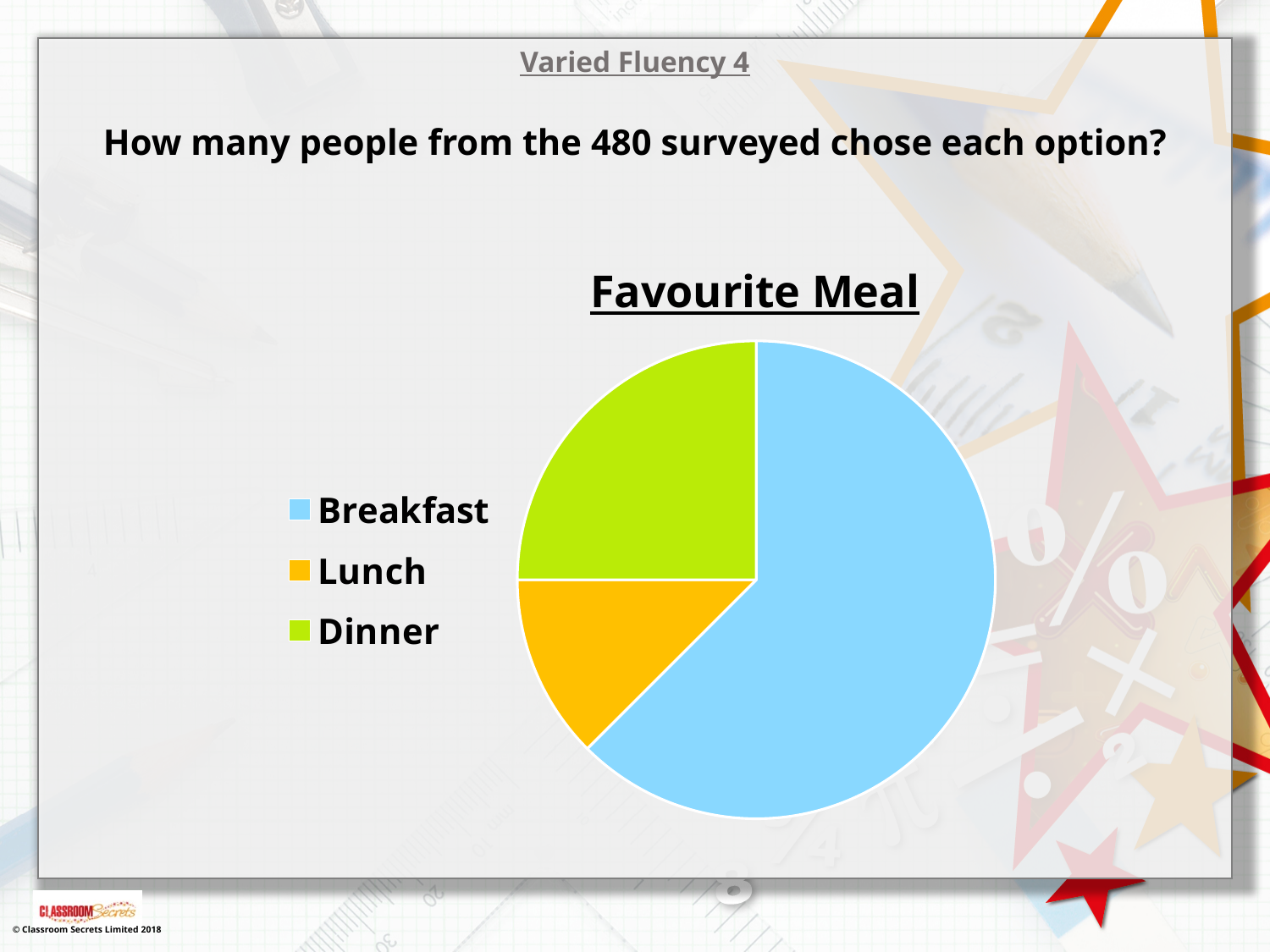
How many entries does the legend list? 3 What type of chart is shown on the slide? pie chart What is the title of the chart? Favourite Meal Which meal has the smallest slice of the pie chart? Lunch Which slice is larger, Lunch or Dinner? Dinner Which meal has the largest slice of the pie chart? Breakfast Which slice is larger, Breakfast or Dinner? Breakfast How many categories does the pie chart show? 3 Does the Breakfast slice take up more or less than half of the pie? more Which colour represents Lunch in the pie chart? orange